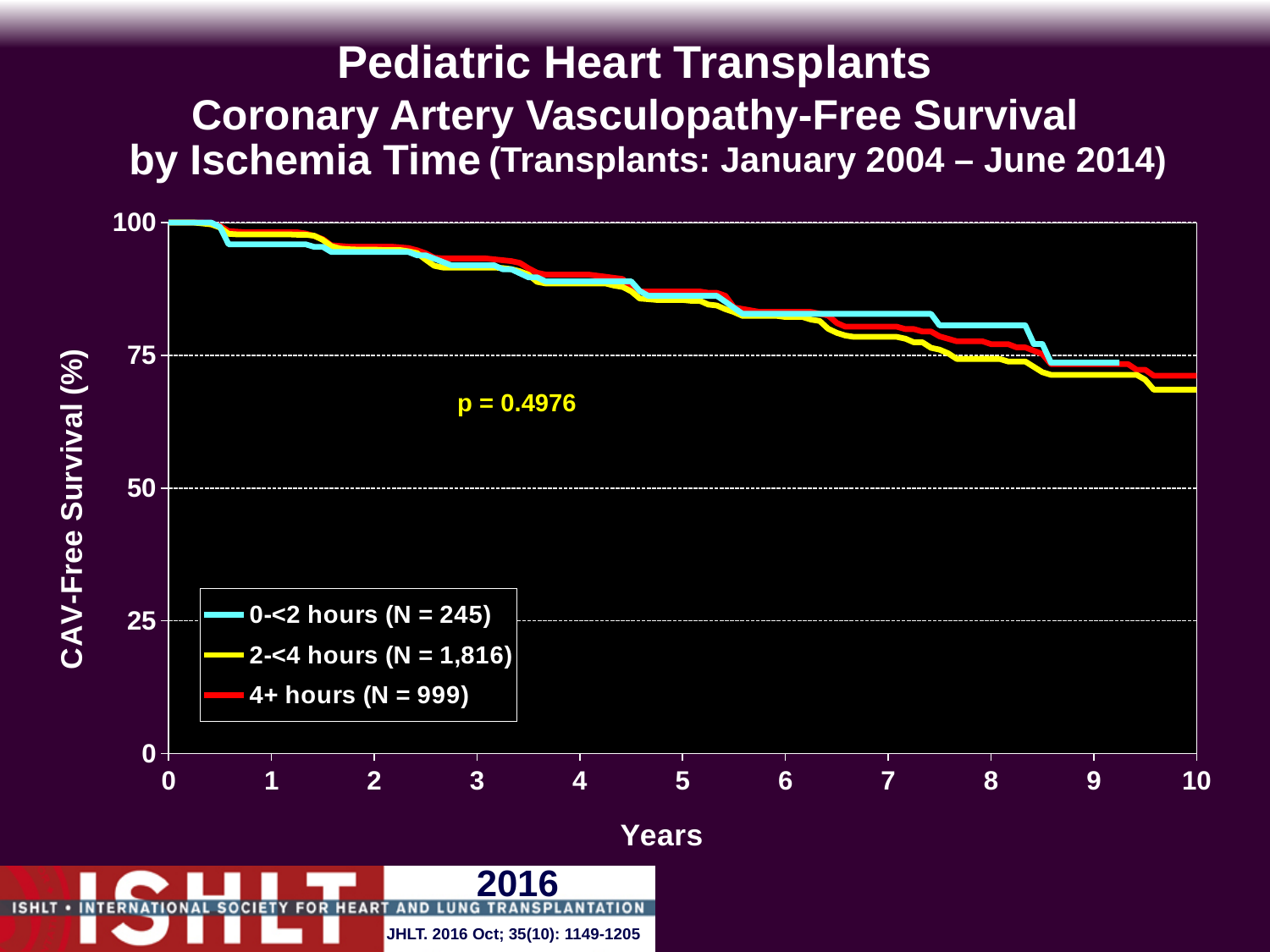
Do the CAV-free survival curves rise or fall as years increase? Fall Is the CAV-free survival for the 2-<4 hours group at 9 years greater or less than 75? less Which ischemia time group has the lowest CAV-free survival at 10 years? 2-<4 hours Is the CAV-free survival for the 4+ hours group at 3 years greater or less than 75? greater Is the CAV-free survival for the 0-<2 hours group at 5 years greater or less than 75? greater What is the p-value shown on the chart? p = 0.4976 How many series does the legend list? 3 Which ischemia time group has the highest CAV-free survival at 8 years? 0-<2 hours What is the N for the 2-<4 hours group in the legend? N = 1,816 At 8 years, is the CAV-free survival for the 0-<2 hours group or the 2-<4 hours group larger? 0-<2 hours What kind of chart is shown on the slide? Line chart